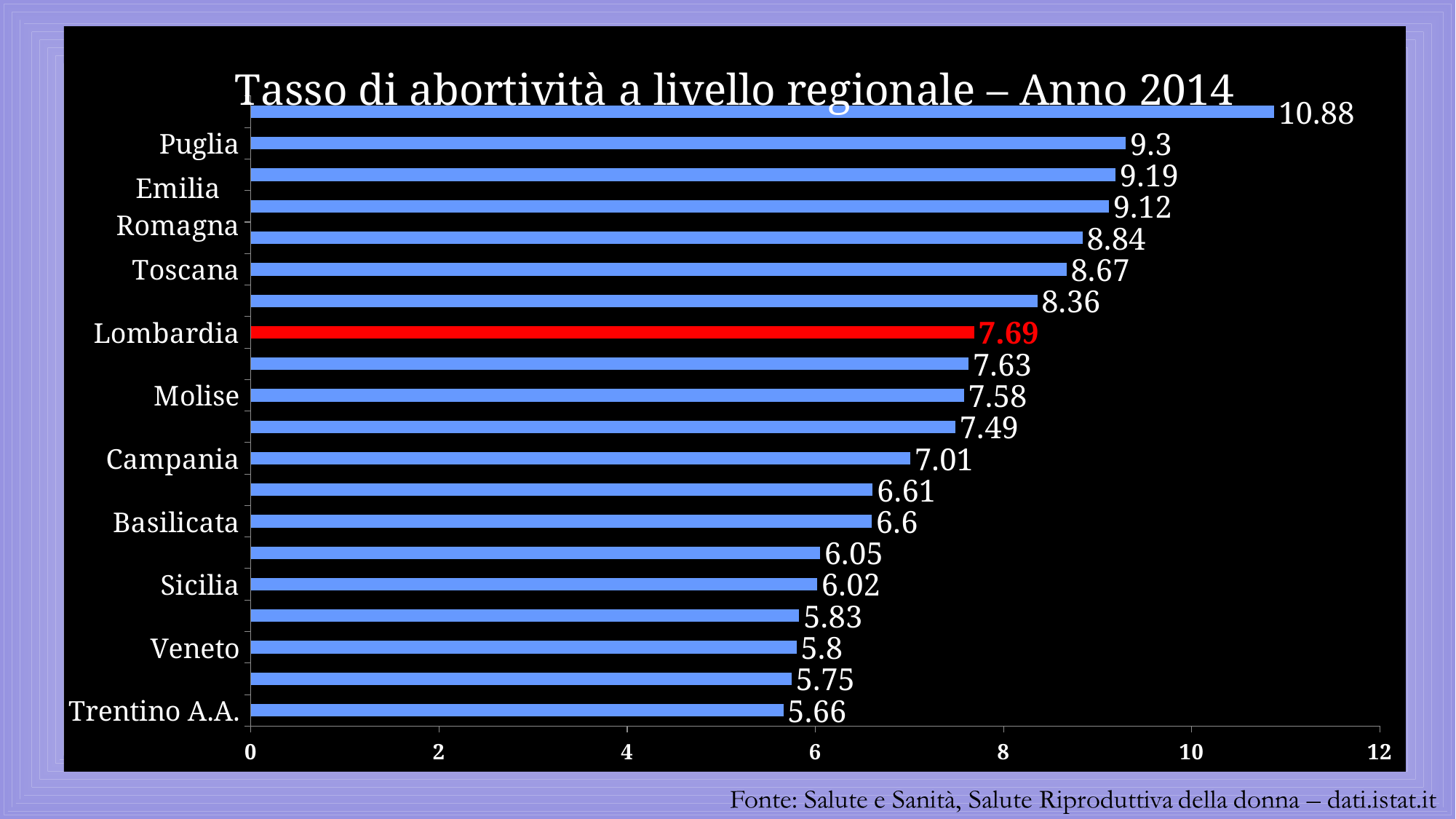
What kind of chart is shown on the slide? bar chart What is the value for Trentino A.A.? 5.66 What is the highest value shown on the chart? 10.88 What is the difference between the values for Puglia and Lombardia? 1.61 What is the value for Puglia? 9.3 What is the value for Toscana? 8.67 How many bars are shown on the chart? 20 Which region has the lowest value? Trentino A.A. Is the value for Sicilia greater or less than 8? less What is the value for Lombardia? 7.69 Which has a larger value, Molise or Campania? Molise Which region's bar is highlighted in red? Lombardia